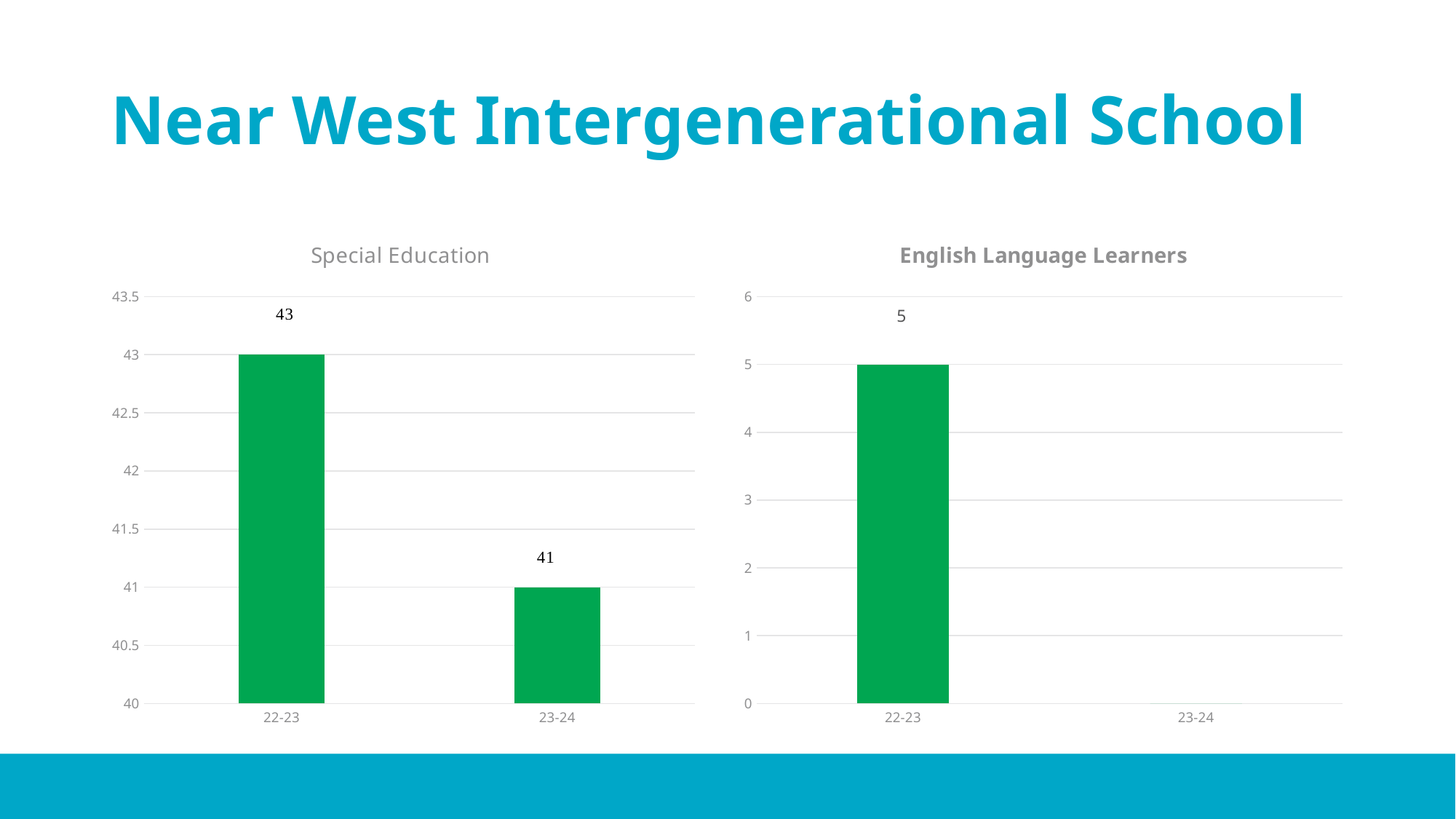
In the English Language Learners chart, is the value for 22-23 greater or less than 4? greater In the Special Education chart, do the values rise or fall from 22-23 to 23-24? fall In the Special Education chart, what is the value for 23-24? 41 In the Special Education chart, what is the value for 22-23? 43 In the Special Education chart, what is the difference between the 22-23 and 23-24 values? 2 How many categories are shown on the x axis of the Special Education chart? 2 What is the title of the chart on the right side of the slide? English Language Learners In the Special Education chart, which year has the lowest value? 23-24 In the Special Education chart, is the value for 22-23 larger or smaller than the value for 23-24? larger What kind of chart is the English Language Learners chart? bar chart In the Special Education chart, which year has the higher value? 22-23 In the English Language Learners chart, what is the value for 22-23? 5